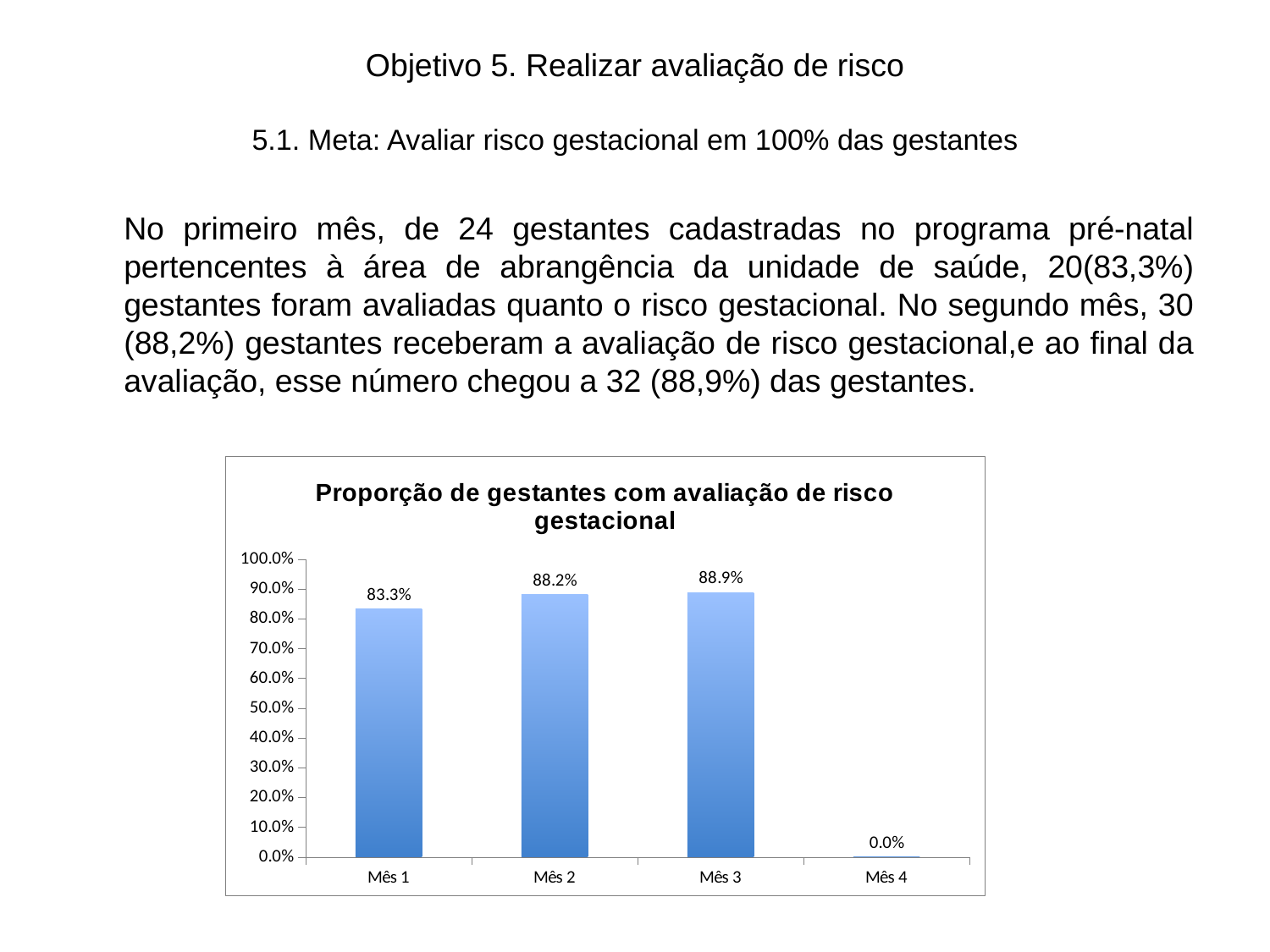
How many months are shown on the x axis? 4 What is the difference between the values for Mês 2 and Mês 1? 4.9% Is the value for Mês 1 greater or less than 80.0%? greater Which is larger, the value for Mês 1 or the value for Mês 2? Mês 2 What is the value for Mês 4? 0.0% What is the value for Mês 1? 83.3% Which month has the lowest value? Mês 4 What is the value for Mês 2? 88.2% What kind of chart is shown? bar chart What is the title of the chart? Proporção de gestantes com avaliação de risco gestacional What is the value for Mês 3? 88.9% Which month has the highest value? Mês 3